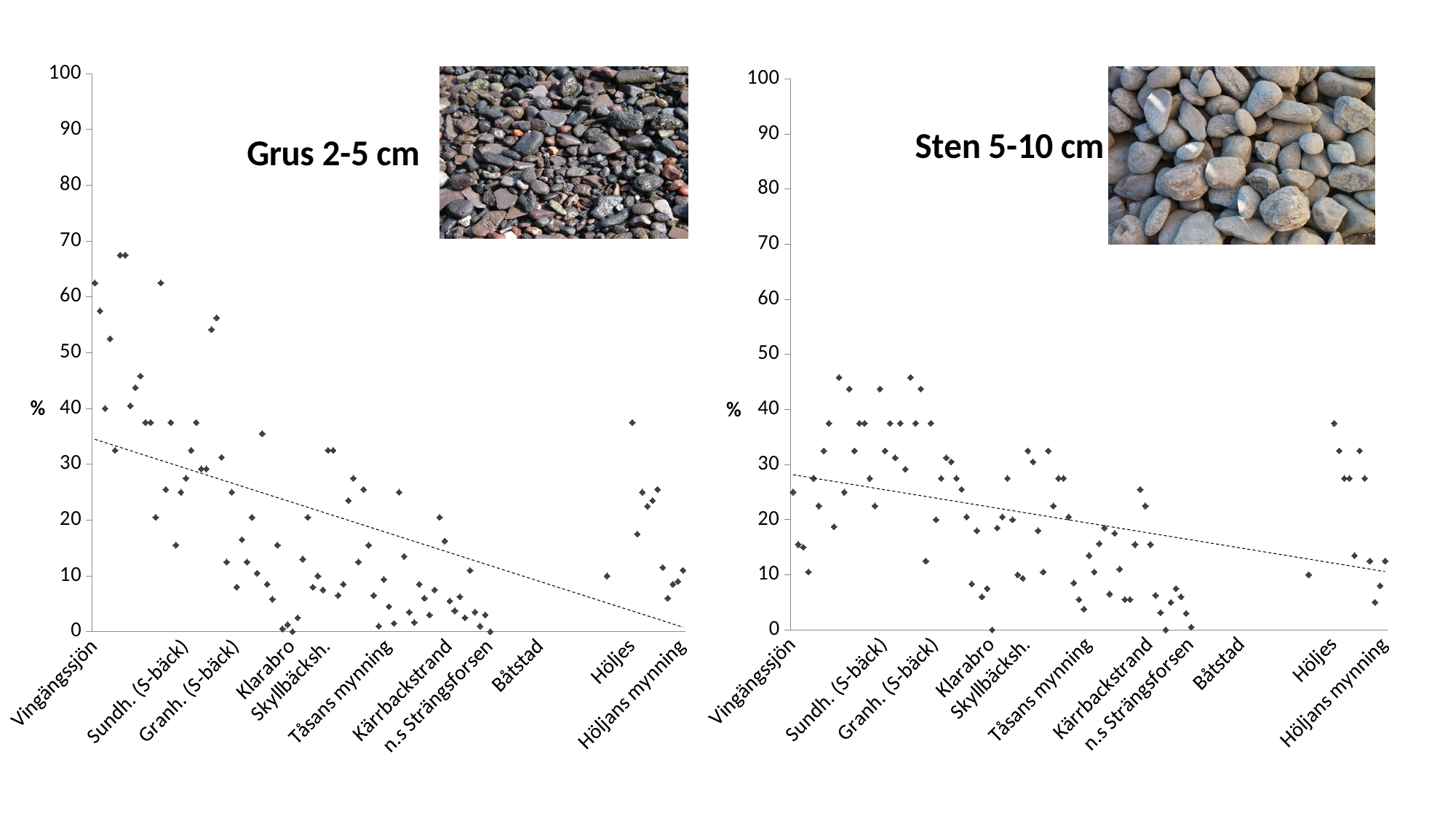
In the "Grus 2-5 cm" chart, does the dashed trend line rise or fall from left to right along the x axis? fall In the "Grus 2-5 cm" chart, is the highest point near Vingängssjön greater or less than 50? greater What is the maximum value shown on the y axis of the "Grus 2-5 cm" chart? 100 How many location labels are shown on the x axis of the "Grus 2-5 cm" chart? 11 What kind of chart is the left chart titled "Grus 2-5 cm"? scatter chart In the "Sten 5-10 cm" chart, does the dashed trend line rise or fall from left to right along the x axis? fall How many location labels are shown on the x axis of the "Sten 5-10 cm" chart? 11 In the "Grus 2-5 cm" chart, is the highest plotted point greater or less than 60? greater Which chart has the higher maximum plotted point, "Grus 2-5 cm" or "Sten 5-10 cm"? Grus 2-5 cm What is the label on the y axis of the "Sten 5-10 cm" chart? % In the "Sten 5-10 cm" chart, is the highest plotted point greater or less than 50? less What kind of chart is the right chart titled "Sten 5-10 cm"? scatter chart